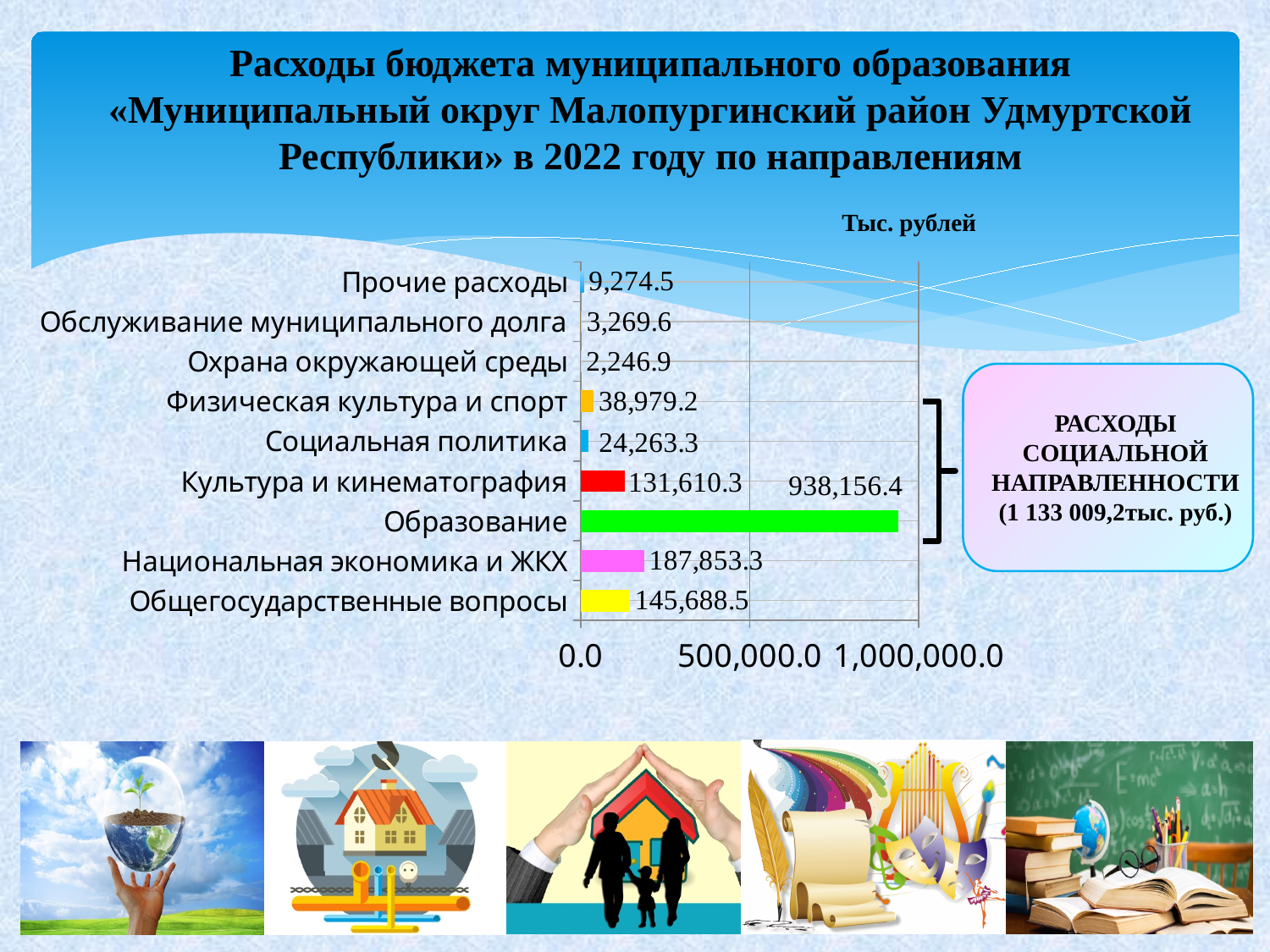
Which category has the lowest value? Охрана окружающей среды What is the value for Культура и кинематография? 131,610.3 Is the value for Образование greater or less than 500,000.0? greater What is the difference between Культура и кинематография and Социальная политика? 107,347.0 What kind of chart is shown on the slide? bar chart How many categories are shown in the chart? 9 What is the value for Национальная экономика и ЖКХ? 187,853.3 Which category has the highest value? Образование What is the value for Образование? 938,156.4 Which is larger, Физическая культура и спорт or Социальная политика? Физическая культура и спорт What is the value for Охрана окружающей среды? 2,246.9 What is the difference between Национальная экономика и ЖКХ and Общегосударственные вопросы? 42,164.8